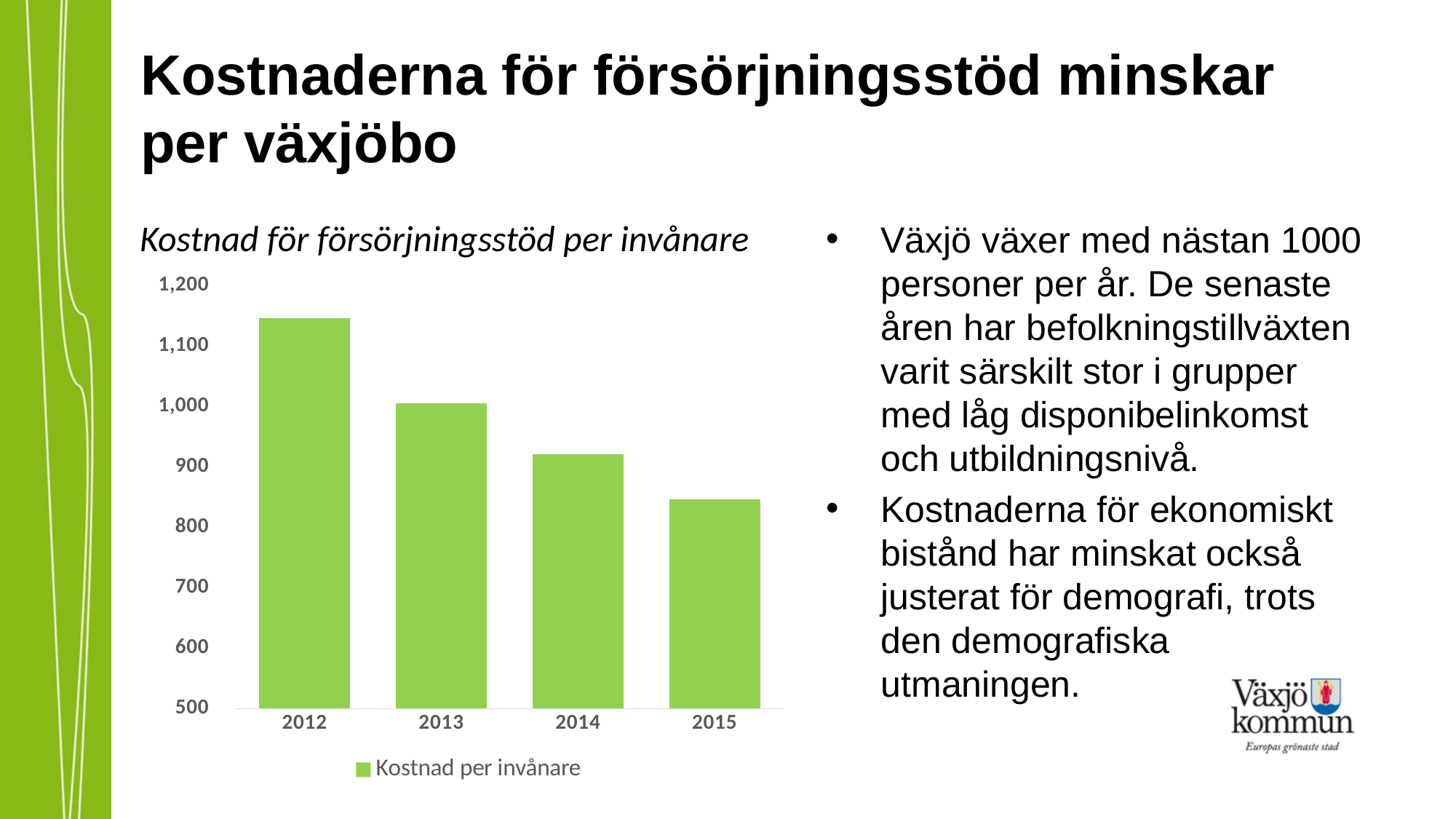
Is the value for 2012 greater or less than 1,100? greater Which year has the highest value in the chart? 2012 How many years are shown on the x axis of the chart? 4 Which year has the lowest value in the chart? 2015 Is the value for 2013 greater or less than 1,100? less What is the title of the chart? Kostnad för försörjningsstöd per invånare Which is larger, the value for 2012 or the value for 2015? 2012 What kind of chart is shown on the slide? bar chart Is the value for 2015 greater or less than 900? less Do the values rise or fall from 2012 to 2015? fall How many series does the chart legend list? 1 What is the legend entry of the chart? Kostnad per invånare